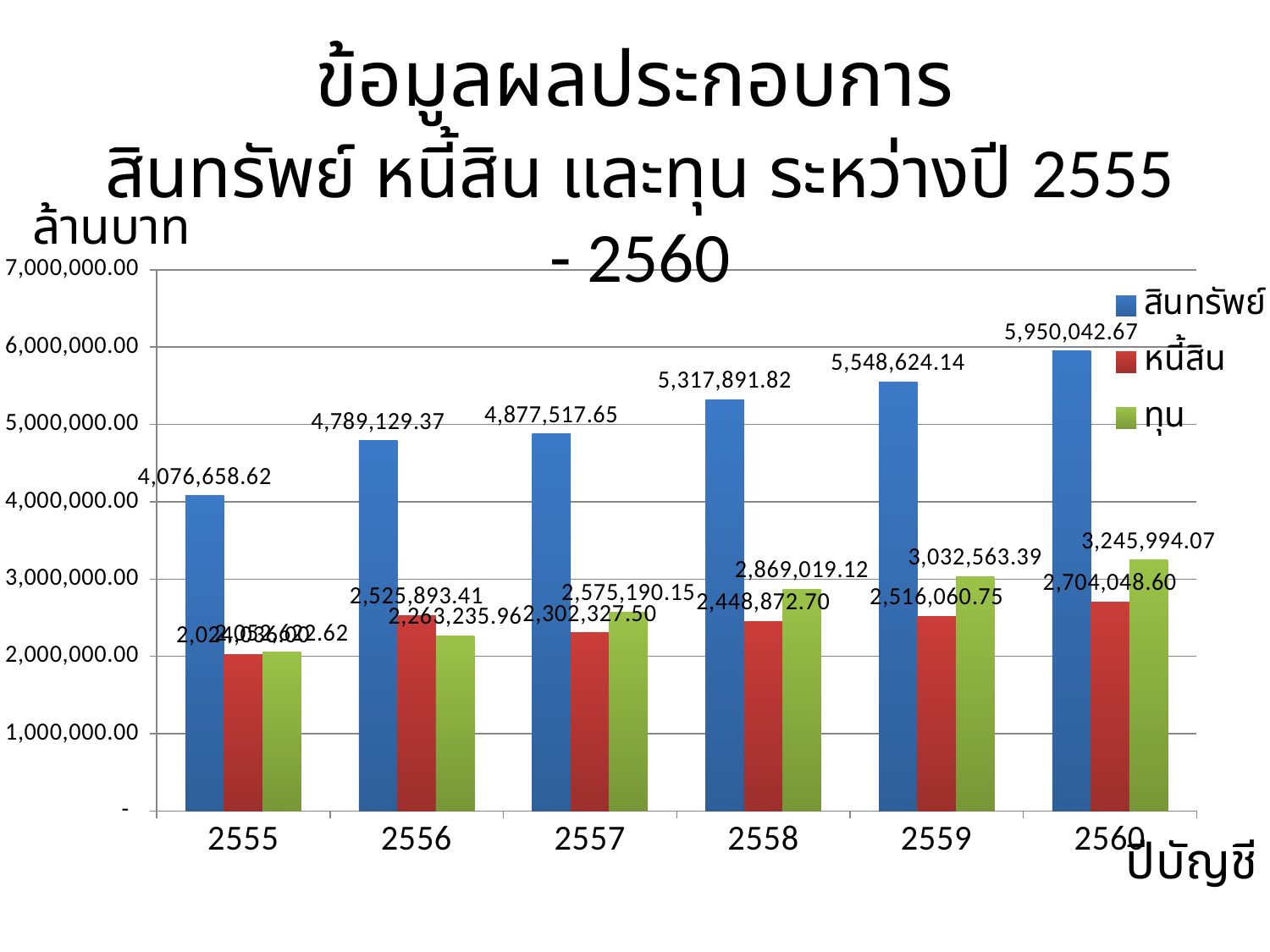
What type of chart is shown on the slide? bar chart In which year is สินทรัพย์ the highest? 2560 How many series does the legend list? 3 Is the value of สินทรัพย์ in 2558 greater or less than 5,000,000.00? greater Which is larger in 2556, หนี้สิน or ทุน? หนี้สิน What is the value of สินทรัพย์ in 2560? 5,950,042.67 What is the difference between สินทรัพย์ and หนี้สิน in 2560? 3,245,994.07 What is the value of ทุน in 2559? 3,032,563.39 Does the value of ทุน rise or fall from 2556 to 2560? rise What is the value of หนี้สิน in 2558? 2,448,872.70 How many years (categories) are shown on the x axis? 6 In which year is สินทรัพย์ the lowest? 2555